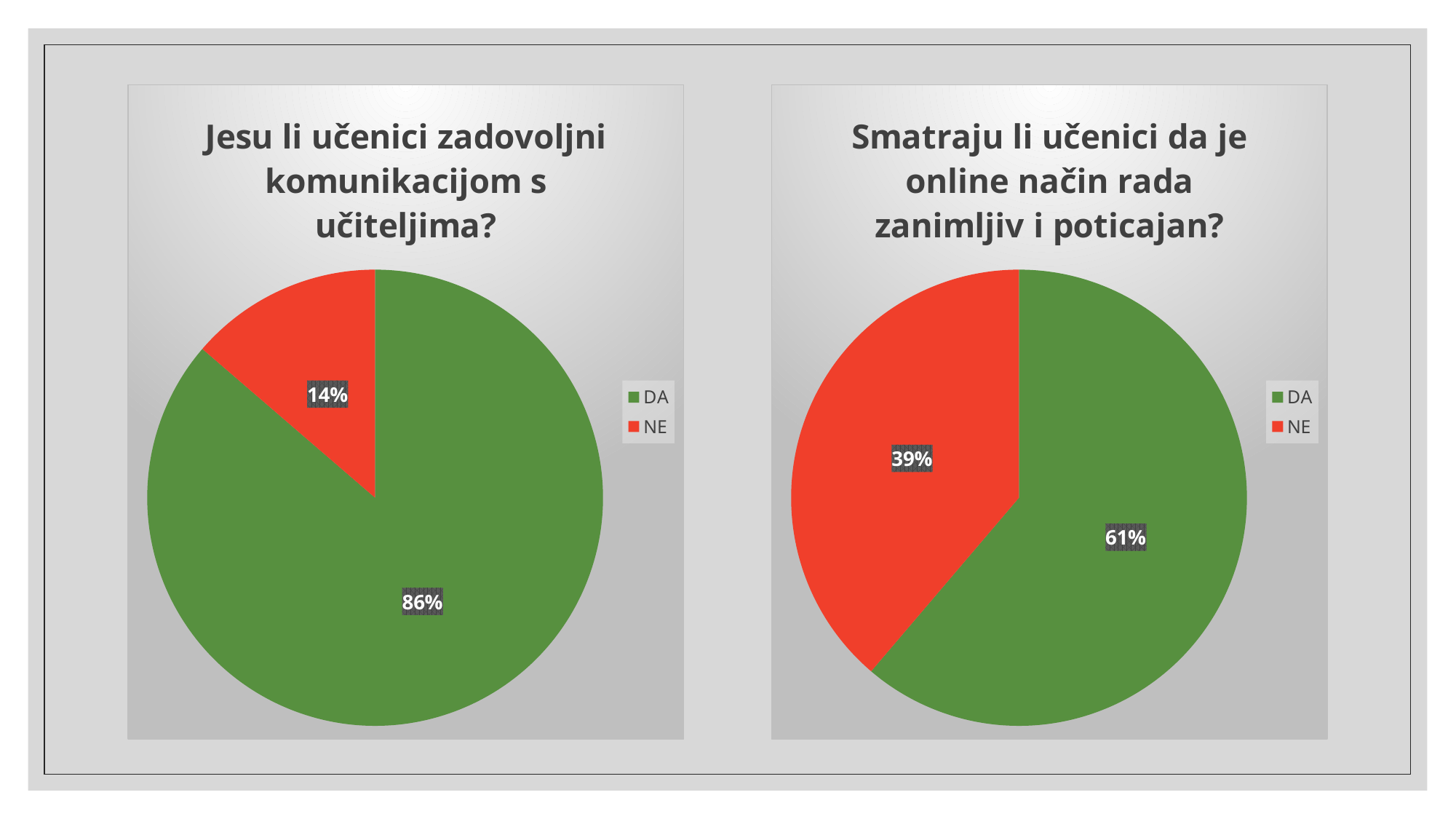
How many categories does the left chart's legend list? 2 In the right chart, which category has the smallest slice? NE In the right chart titled "Smatraju li učenici da je online način rada zanimljiv i poticajan?", what share of the pie is DA? 61% In the left chart titled "Jesu li učenici zadovoljni komunikacijom s učiteljima?", what share of the pie is DA? 86% In the left chart, what is the difference between the DA and NE shares? 72% Is the DA share larger in the left chart or in the right chart? Left chart In the right chart, what is the difference between the DA and NE shares? 22% In the left chart titled "Jesu li učenici zadovoljni komunikacijom s učiteljima?", what share of the pie is NE? 14% In the left chart, which category has the largest slice? DA What kind of chart is the right chart? Pie chart In the right chart, what colour is the NE slice? Red